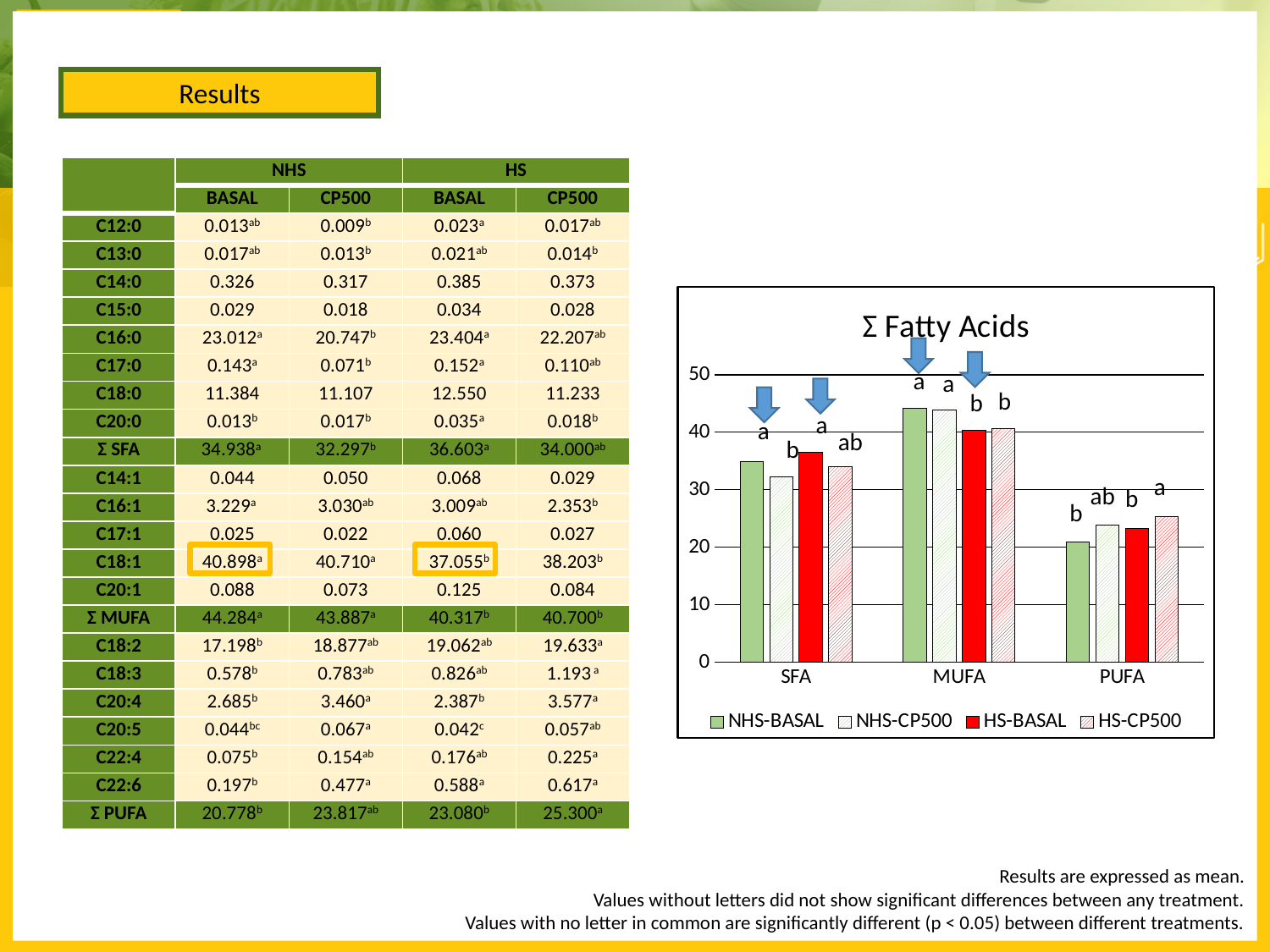
How many series does the chart legend list? 4 Is the NHS-BASAL value for PUFA greater or less than 30? less Is the HS-CP500 value for PUFA greater or less than 20? greater What is the title of the chart? Σ Fatty Acids What kind of chart is shown on the slide? bar chart For PUFA, which is larger: NHS-BASAL or HS-CP500? HS-CP500 Which category has the shortest bars in the chart? PUFA Which category has the tallest bars in the chart? MUFA Is the NHS-BASAL value for MUFA greater or less than 40? greater Which series is drawn in solid red in the chart? HS-BASAL How many categories are shown on the x axis of the chart? 3 For SFA, which is larger: NHS-BASAL or NHS-CP500? NHS-BASAL